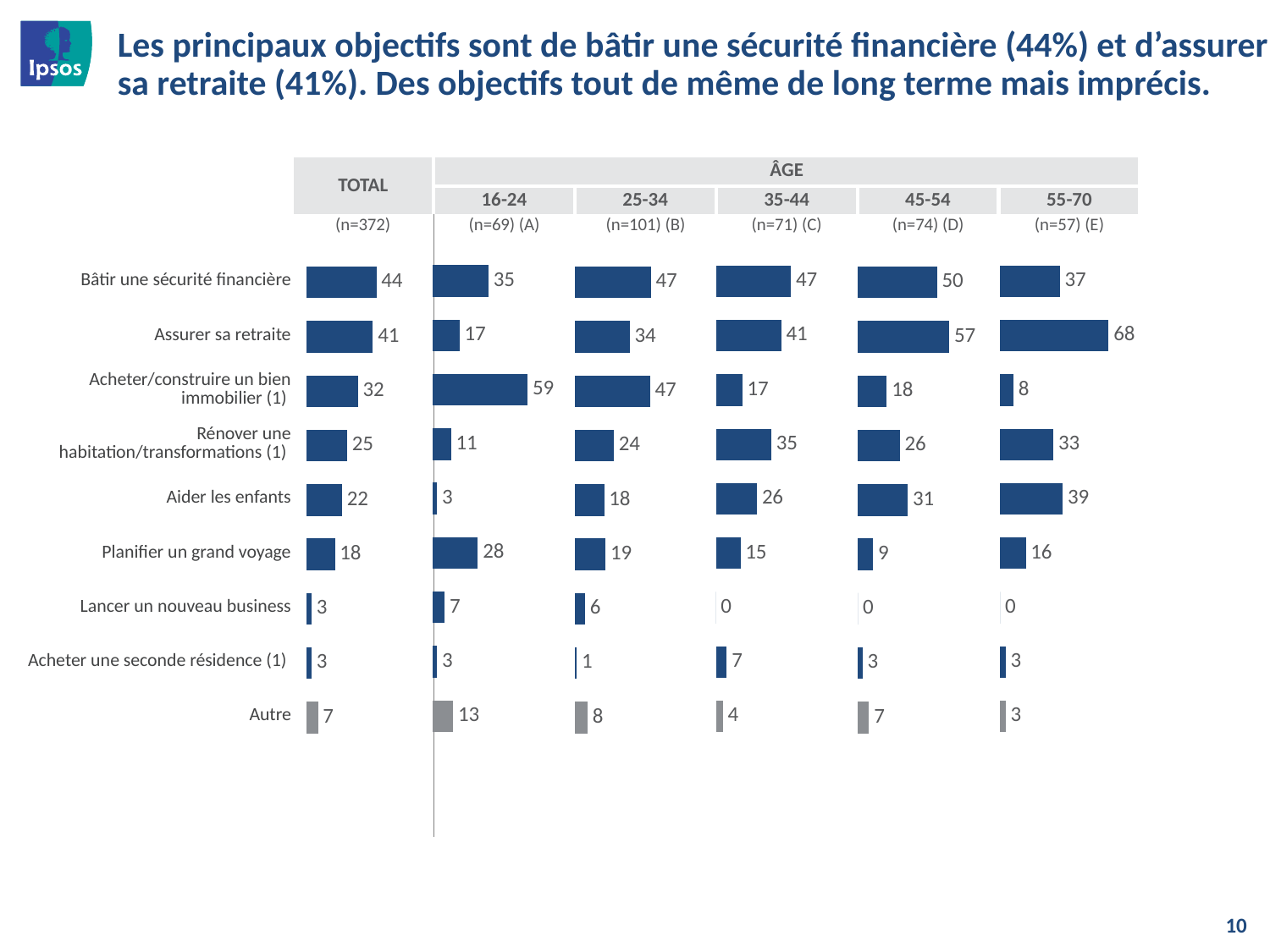
In the 55-70 chart, what is the value for "Lancer un nouveau business"? 0 In the 16-24 chart, which category has the lowest value? Aider les enfants and Acheter une seconde résidence (1) (both 3) In the 55-70 chart, which category has the highest value? Assurer sa retraite What is the sample size (n) shown for the 25-34 chart? n=101 How many categories are shown in the TOTAL chart? 9 In the 35-44 chart, which is larger: "Rénover une habitation/transformations (1)" or "Aider les enfants"? Rénover une habitation/transformations (1) In the 25-34 chart, what is the value for "Acheter une seconde résidence (1)"? 1 In the 16-24 chart, what is the difference between "Planifier un grand voyage" and "Assurer sa retraite"? 11 In the 45-54 chart, what is the difference between "Assurer sa retraite" and "Bâtir une sécurité financière"? 7 In the 16-24 chart, what is the value for "Acheter/construire un bien immobilier (1)"? 59 In the TOTAL chart, what is the value for "Bâtir une sécurité financière"? 44 What kind of chart is used in the TOTAL column? Bar chart